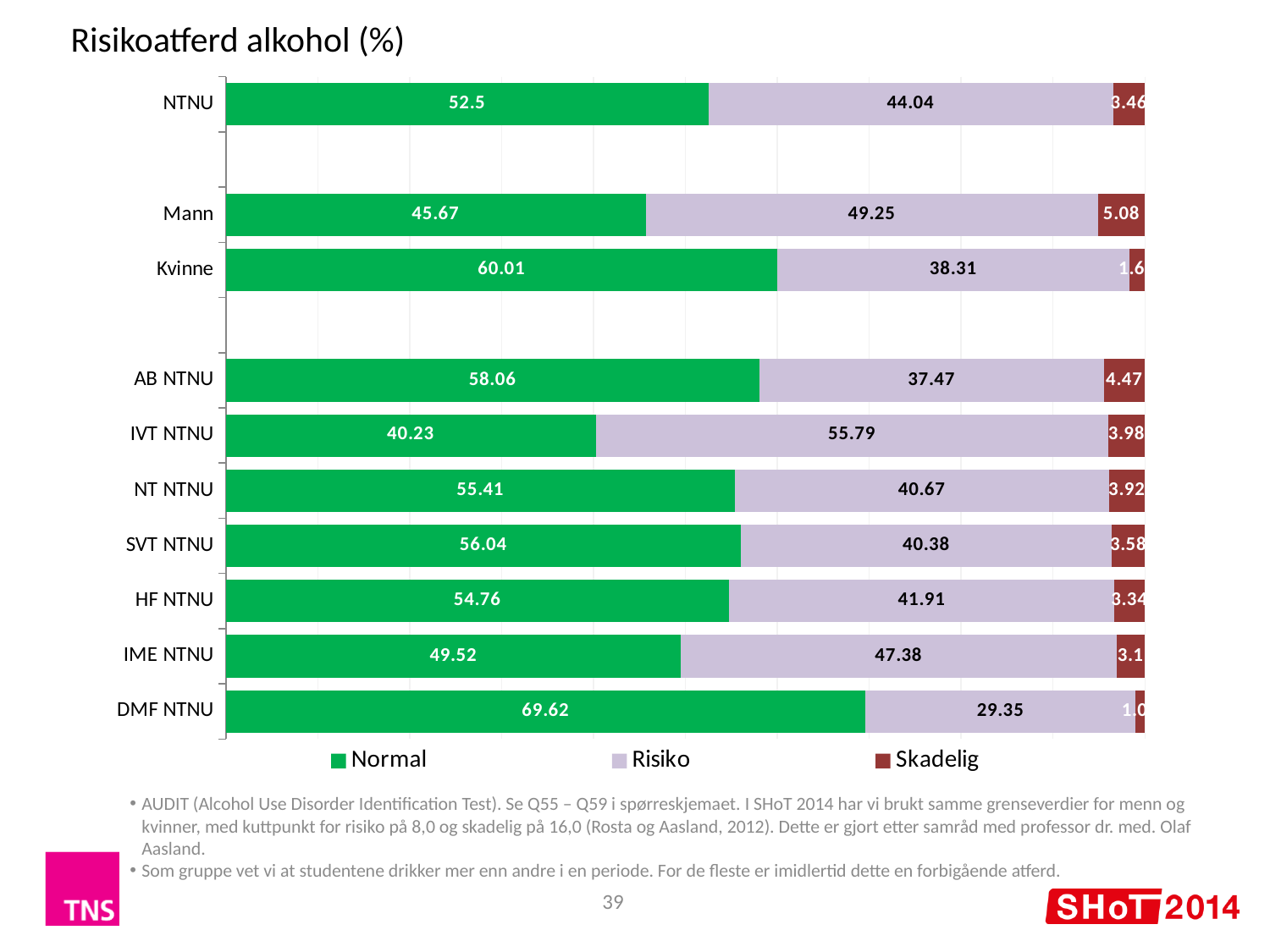
Which category has the lowest Normal value? IVT NTNU What kind of chart is shown on the slide? Stacked bar chart How many categories are shown on the y axis? 10 What is the Risiko value for Mann? 49.25 How many series does the legend list? 3 What is the Normal value for NTNU? 52.5 Which category has the highest Skadelig value? Mann What is the total of the stacked bar for NTNU? 100 What is the difference between the Normal values for Kvinne and Mann? 14.34 Which has a larger Risiko value, IVT NTNU or NT NTNU? IVT NTNU What is the Skadelig value for AB NTNU? 4.47 Which category has the highest Normal value? DMF NTNU